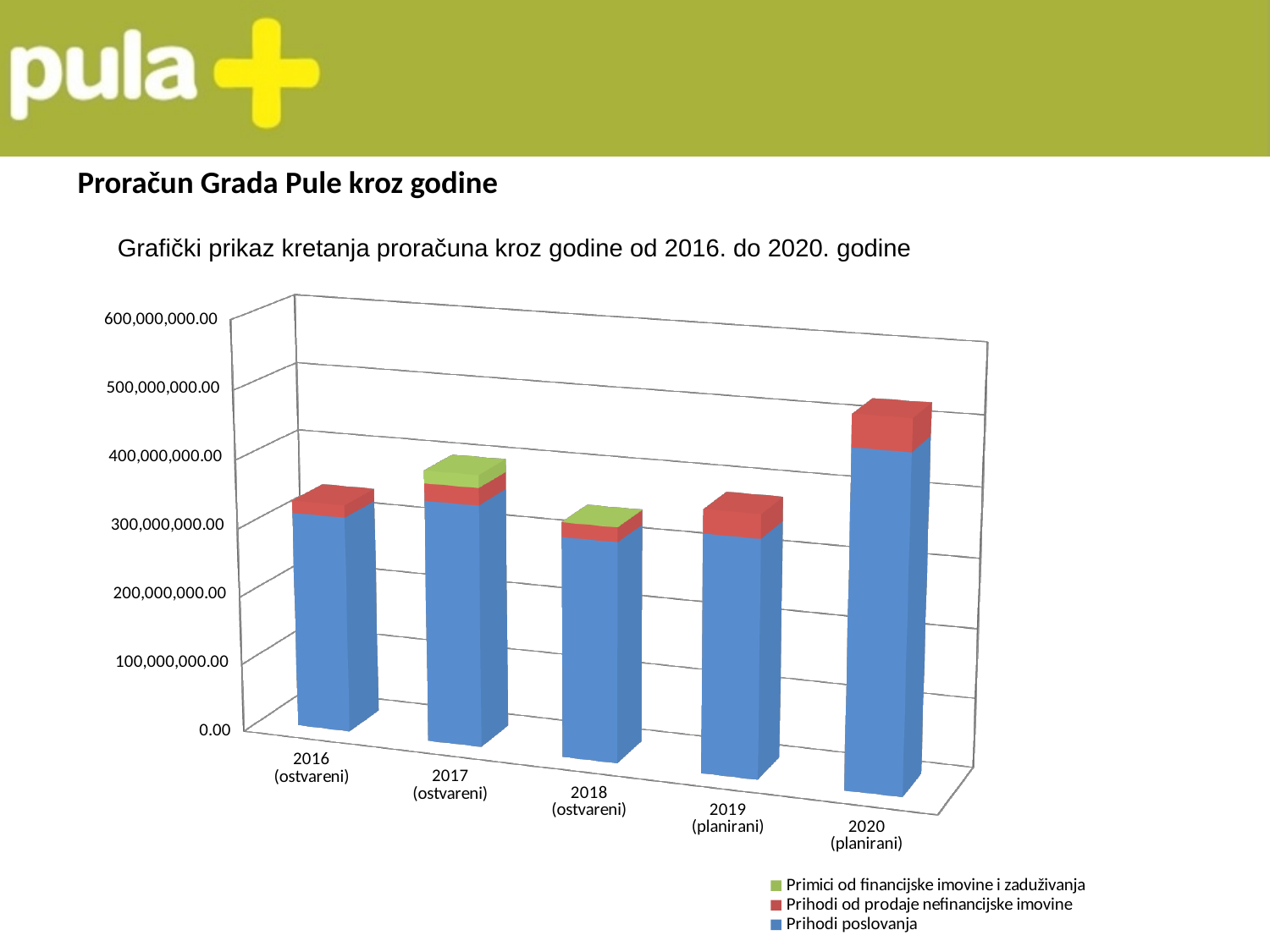
Which year has the tallest stacked bar in the chart? 2020 (planirani) How many series does the chart legend list? 3 Is the total value of the bar for 2020 (planirani) greater or less than 400,000,000.00? greater Is the total value of the bar for 2018 (ostvareni) greater or less than 500,000,000.00? less Which series is shown in green in the chart legend? Primici od financijske imovine i zaduživanja How many year categories are shown on the x axis of the chart? 5 Which series is shown in blue in the chart legend? Prihodi poslovanja What kind of chart is shown on the slide? Stacked bar chart Which bar is taller, 2020 (planirani) or 2016 (ostvareni)? 2020 (planirani) How many of the bars include a green segment (Primici od financijske imovine i zaduživanja)? 2 Is the total value of the bar for 2016 (ostvareni) greater or less than 400,000,000.00? less